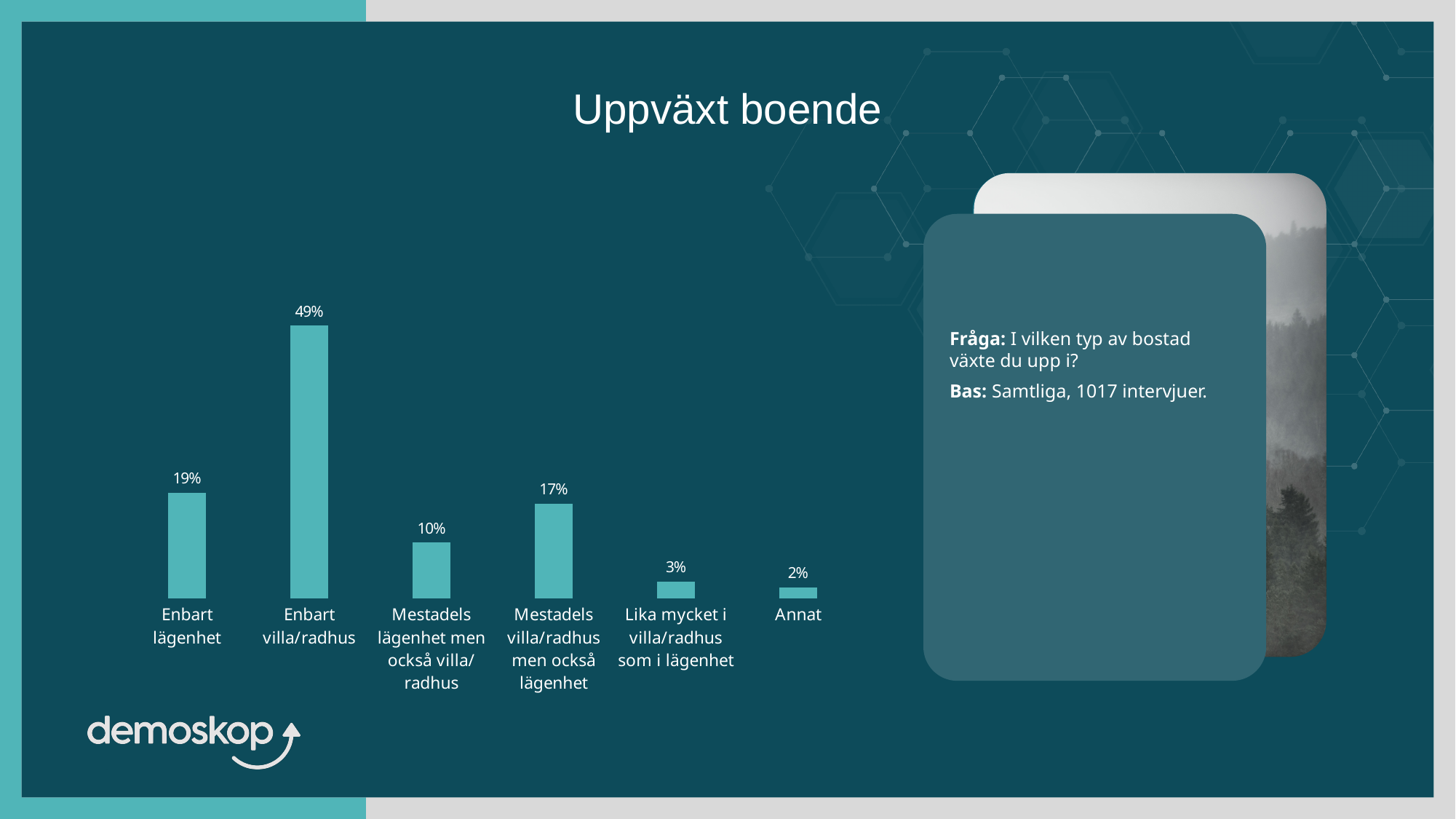
What is the value for Enbart villa/radhus? 49% What is the value for Mestadels lägenhet men också villa/radhus? 10% What is the difference between Enbart villa/radhus and Enbart lägenhet? 30% Which is larger, Mestadels villa/radhus men också lägenhet or Mestadels lägenhet men också villa/radhus? Mestadels villa/radhus men också lägenhet What is the difference between Enbart lägenhet and Mestadels villa/radhus men också lägenhet? 2% What kind of chart is shown on the slide? Bar chart How many categories are shown in the chart? 6 Which category has the lowest value? Annat Which category has the highest value? Enbart villa/radhus What is the value for Lika mycket i villa/radhus som i lägenhet? 3% What is the title of the chart? Uppväxt boende What is the value for Enbart lägenhet? 19%